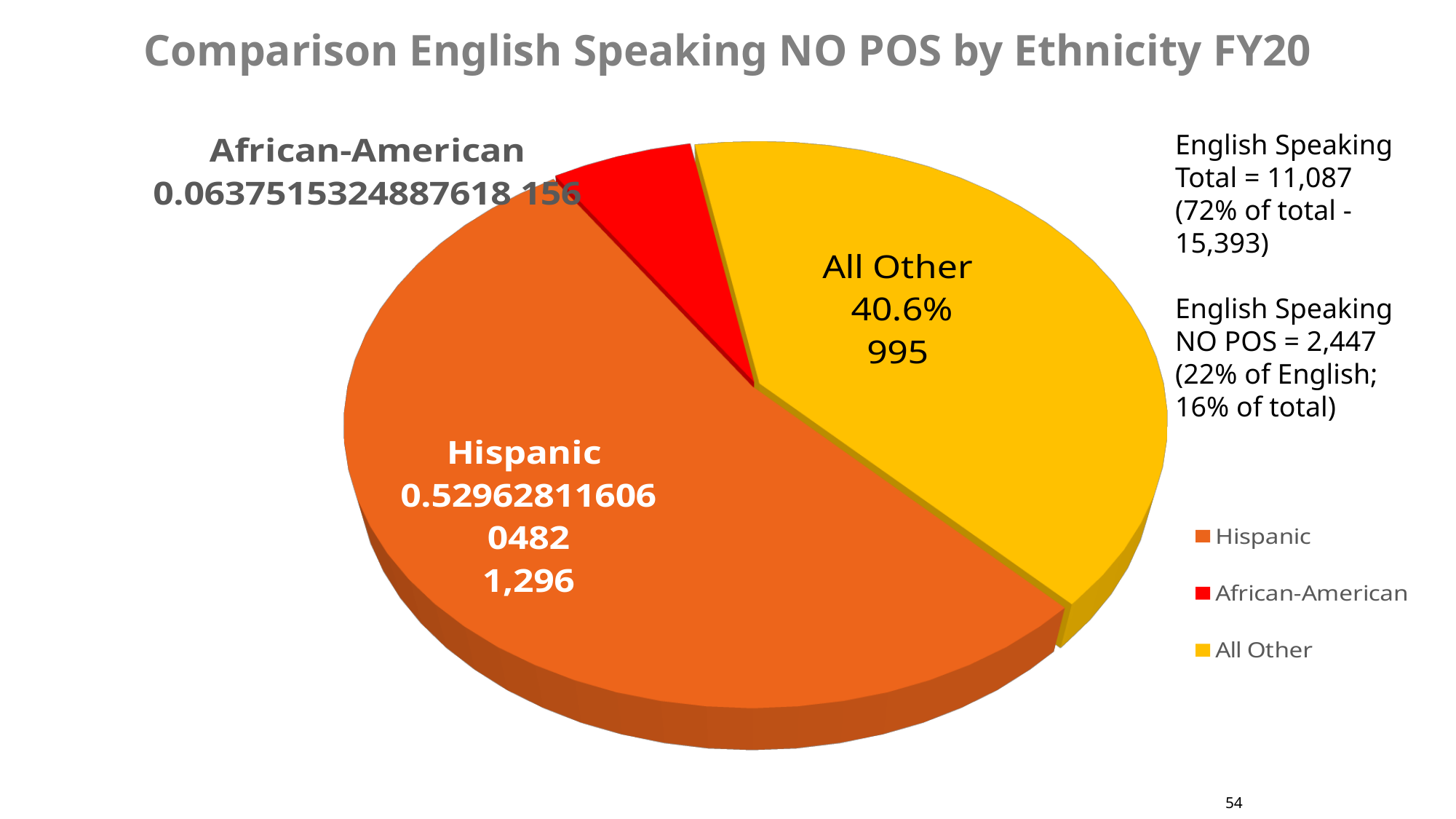
What is the count shown for the African-American slice? 156 What kind of chart is shown on the slide? pie chart What percentage share of the pie is the All Other slice? 40.6% What is the title of the chart? Comparison English Speaking NO POS by Ethnicity FY20 How many slices does the pie chart have? 3 How many entries does the legend list? 3 What is the count shown for the Hispanic slice? 1,296 What is the difference between the Hispanic count and the All Other count? 301 What is the count shown for the All Other slice? 995 Which is larger, the All Other count or the African-American count? All Other Which ethnicity has the largest slice of the pie? Hispanic Which ethnicity has the smallest slice of the pie? African-American